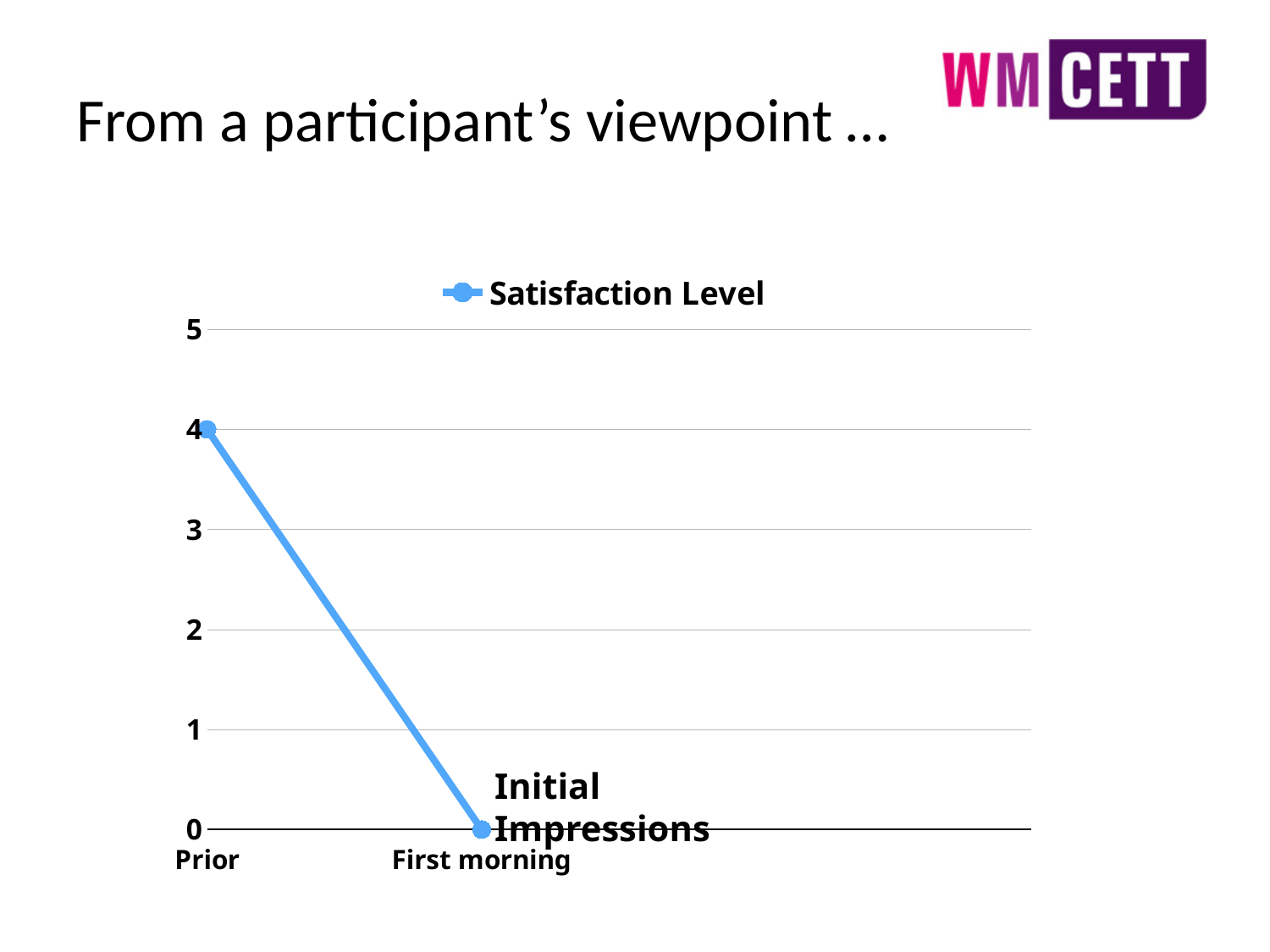
How many series does the legend list? 1 Which category has the lowest Satisfaction Level? First morning Is the Satisfaction Level for Prior greater or less than 3? greater Which is larger, the Satisfaction Level for Prior or for First morning? Prior How many categories are plotted on the x axis? 2 What is the name of the series shown in the legend? Satisfaction Level What is the Satisfaction Level value for First morning? 0 What is the difference in Satisfaction Level between Prior and First morning? 4 What kind of chart is shown on the slide? line chart What is the Satisfaction Level value for Prior? 4 Which category has the highest Satisfaction Level? Prior Does the Satisfaction Level rise or fall from Prior to First morning? fall